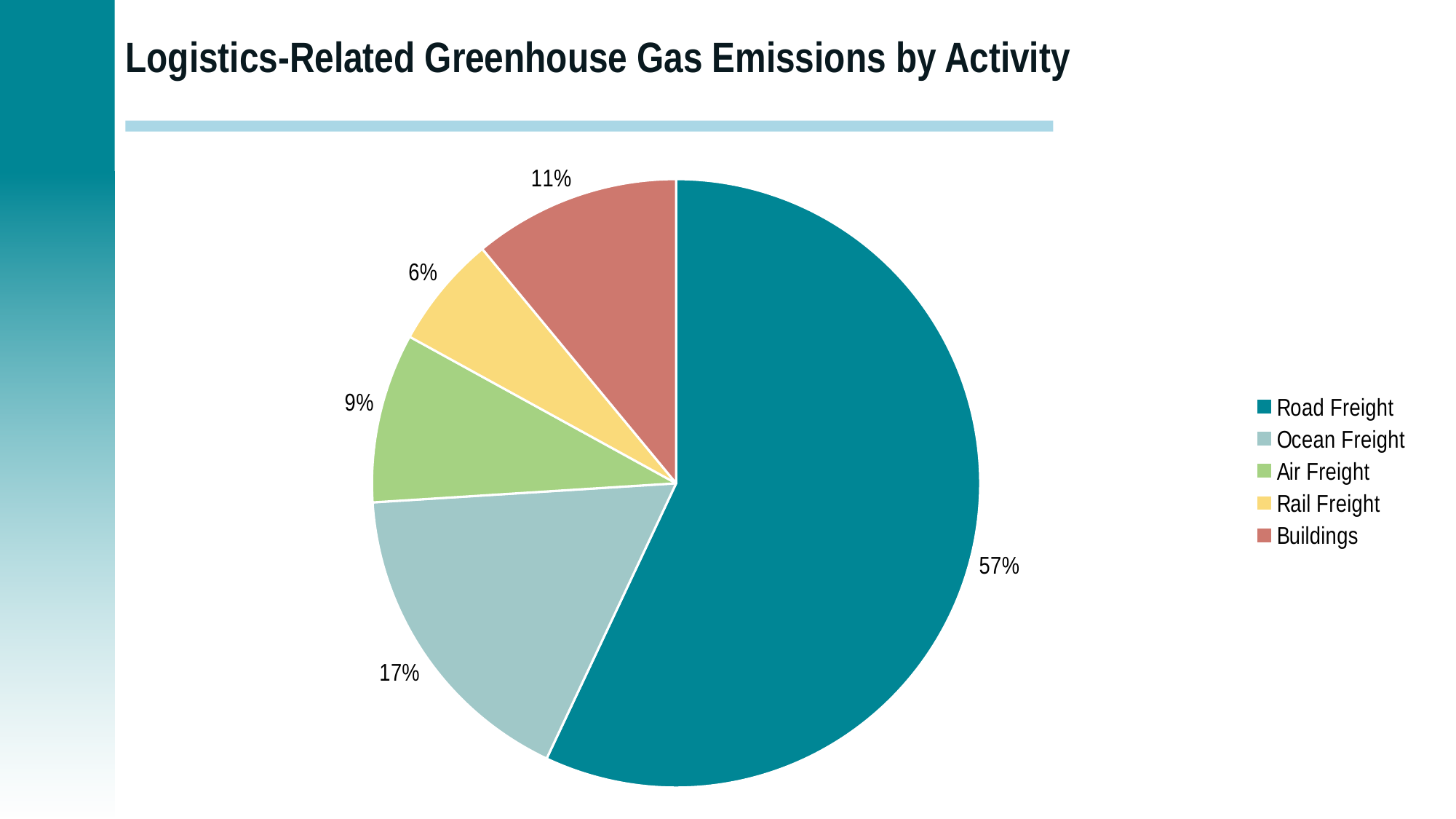
Which has a larger share of emissions, Buildings or Air Freight? Buildings What is the difference in percentage points between Road Freight and Ocean Freight? 40 What share of logistics-related greenhouse gas emissions comes from Road Freight? 57% What percentage of emissions is attributed to Air Freight? 9% How many activity categories are shown in the pie chart? 5 What percentage of emissions is attributed to Rail Freight? 6% What percentage of emissions is attributed to Ocean Freight? 17% What percentage of emissions is attributed to Buildings? 11% Which activity accounts for the largest share of emissions? Road Freight What type of chart is shown on the slide? Pie chart Which activity accounts for the smallest share of emissions? Rail Freight What is the title of the chart? Logistics-Related Greenhouse Gas Emissions by Activity